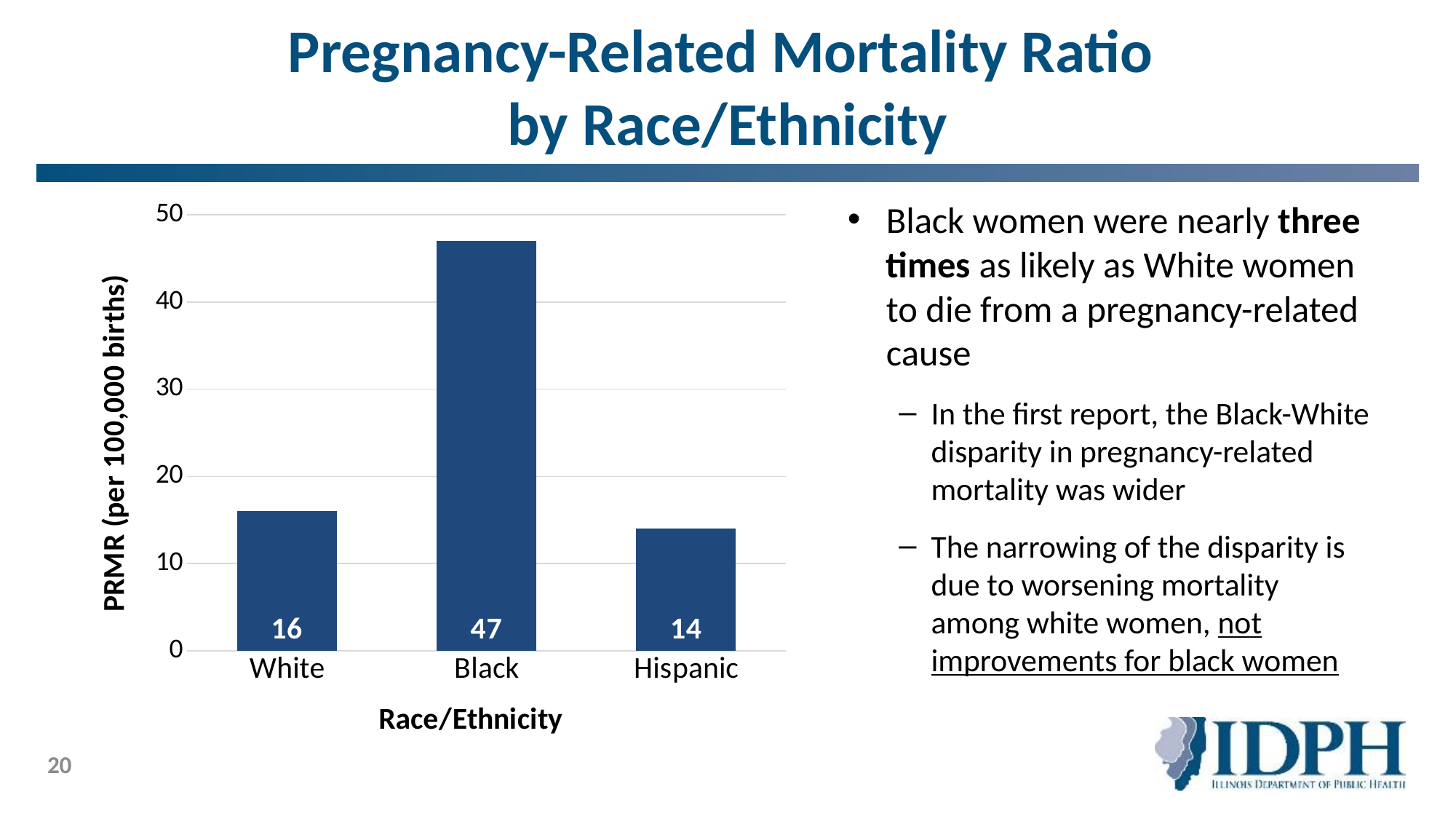
Which race/ethnicity has the highest PRMR? Black What is the difference between the PRMR for Black women and the PRMR for White women? 31 What kind of chart is shown on the slide? Bar chart What is the PRMR for Black women? 47 What is the label of the vertical axis of the chart? PRMR (per 100,000 births) What is the difference between the PRMR for White women and the PRMR for Hispanic women? 2 How many race/ethnicity categories are shown in the chart? 3 Which is larger, the PRMR for White women or for Hispanic women? White What is the PRMR for Hispanic women? 14 Which race/ethnicity has the lowest PRMR? Hispanic What is the PRMR for White women? 16 Is the PRMR for Black women greater or less than 40? greater